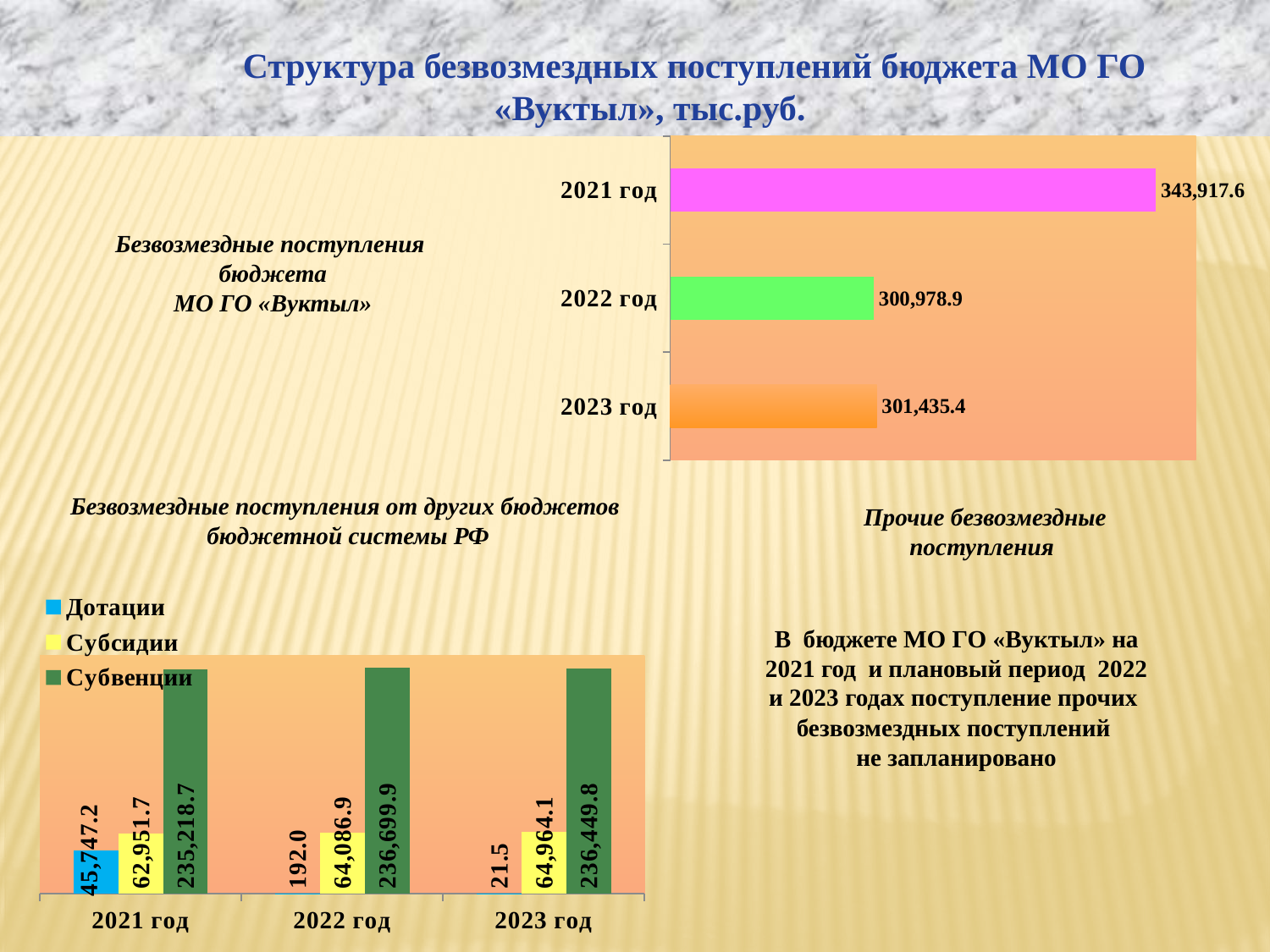
In the chart «Безвозмездные поступления бюджета МО ГО «Вуктыл»», how many years are shown? 3 In the chart «Безвозмездные поступления бюджета МО ГО «Вуктыл»», what is the difference between the values for 2021 год and 2022 год? 42,938.7 In the chart «Безвозмездные поступления от других бюджетов бюджетной системы РФ», how many series does the legend list? 3 In the chart «Безвозмездные поступления бюджета МО ГО «Вуктыл»», what is the value for 2021 год? 343,917.6 In the chart «Безвозмездные поступления от других бюджетов бюджетной системы РФ», what is the difference between Субвенции and Дотации for 2021 год? 189,471.5 In the chart «Безвозмездные поступления от других бюджетов бюджетной системы РФ», in which year is Дотации highest? 2021 год In the chart «Безвозмездные поступления от других бюджетов бюджетной системы РФ», what is the value of Субсидии for 2022 год? 64,086.9 In the chart «Безвозмездные поступления бюджета МО ГО «Вуктыл»», what is the value for 2023 год? 301,435.4 What type of chart is «Безвозмездные поступления бюджета МО ГО «Вуктыл»»? Bar chart In the chart «Безвозмездные поступления от других бюджетов бюджетной системы РФ», what is the value of Дотации for 2023 год? 21.5 In the chart «Безвозмездные поступления от других бюджетов бюджетной системы РФ», do the values of Дотации rise or fall from 2021 год to 2023 год? Fall In the chart «Безвозмездные поступления бюджета МО ГО «Вуктыл»», which year has the highest value? 2021 год